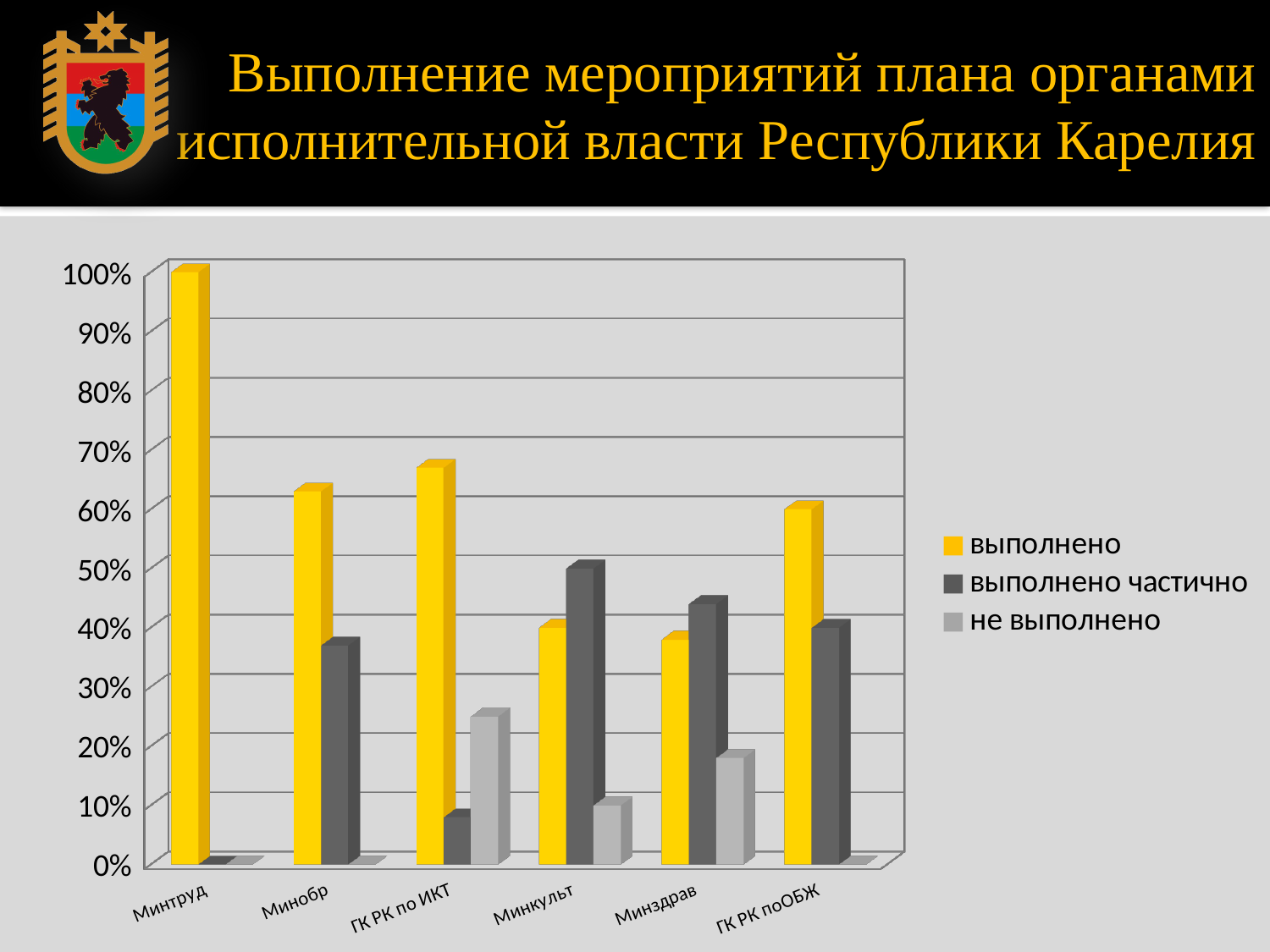
Is the 'выполнено' value for Минтруд greater or less than 90%? greater What kind of chart is shown on the slide? bar chart Which category has the highest value for the series 'не выполнено'? ГК РК по ИКТ Which colour represents the series 'выполнено' in the legend? yellow How many categories (government bodies) are shown on the x axis? 6 How many series does the legend list? 3 For Минкульт, which is larger: 'выполнено' or 'выполнено частично'? выполнено частично Is the 'не выполнено' value for ГК РК по ИКТ greater or less than 20%? greater Which category has the highest value for the series 'выполнено'? Минтруд Which category has the highest value for the series 'выполнено частично'? Минкульт Is the 'выполнено частично' value for Минобр greater or less than 30%? greater